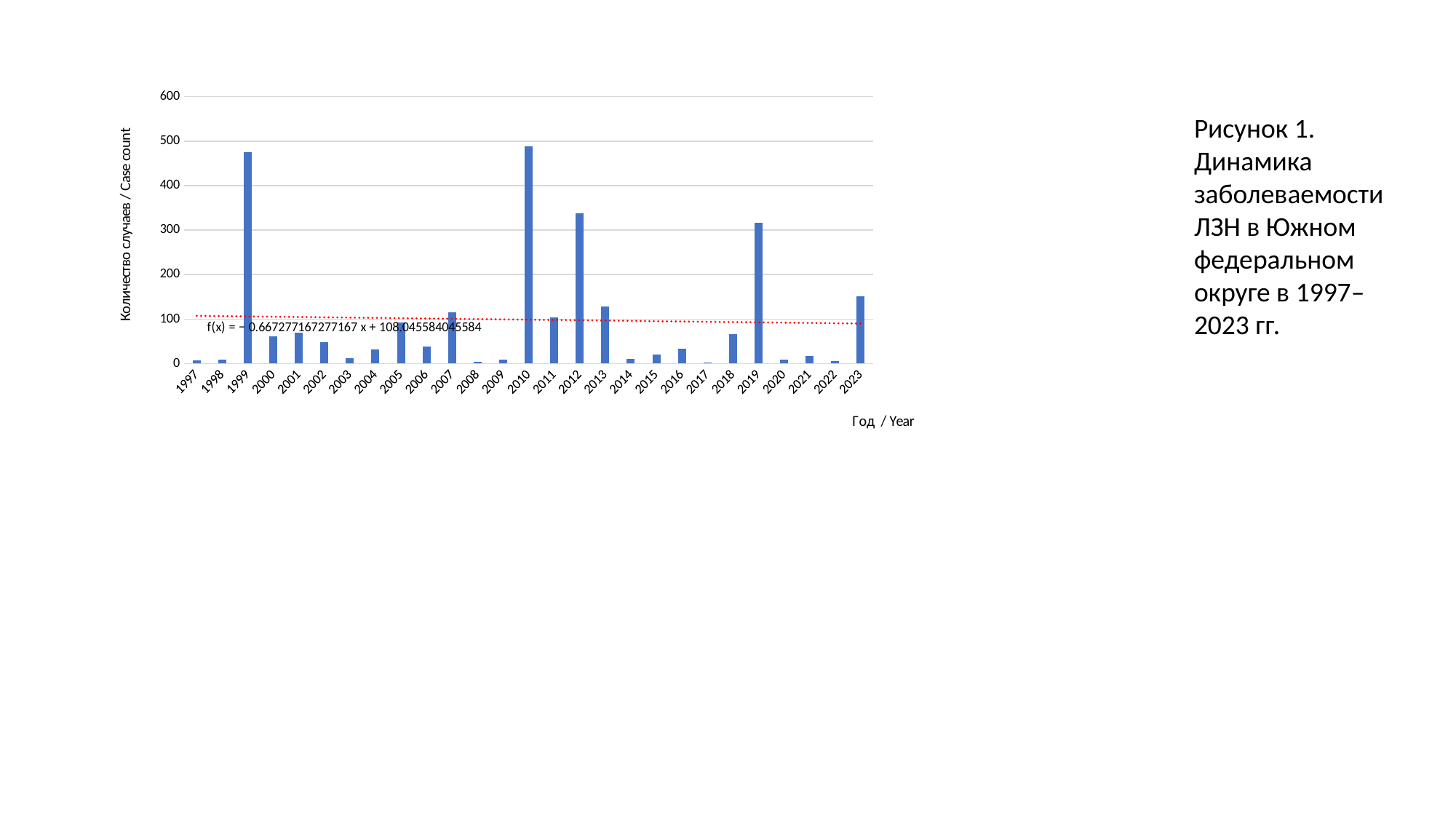
Is the value for 2019 greater or less than 300? greater What is the label of the vertical axis of the chart? Количество случаев / Case count According to the dotted trend line, do the values rise or fall over the years? fall How many years are shown on the x axis of the chart? 27 Is the value for 2023 greater or less than 100? greater Is the value for 2018 greater or less than 100? less Which year has the larger value, 1999 or 2012? 1999 What kind of chart is shown on the slide? bar chart Which year has the larger value, 2019 or 2023? 2019